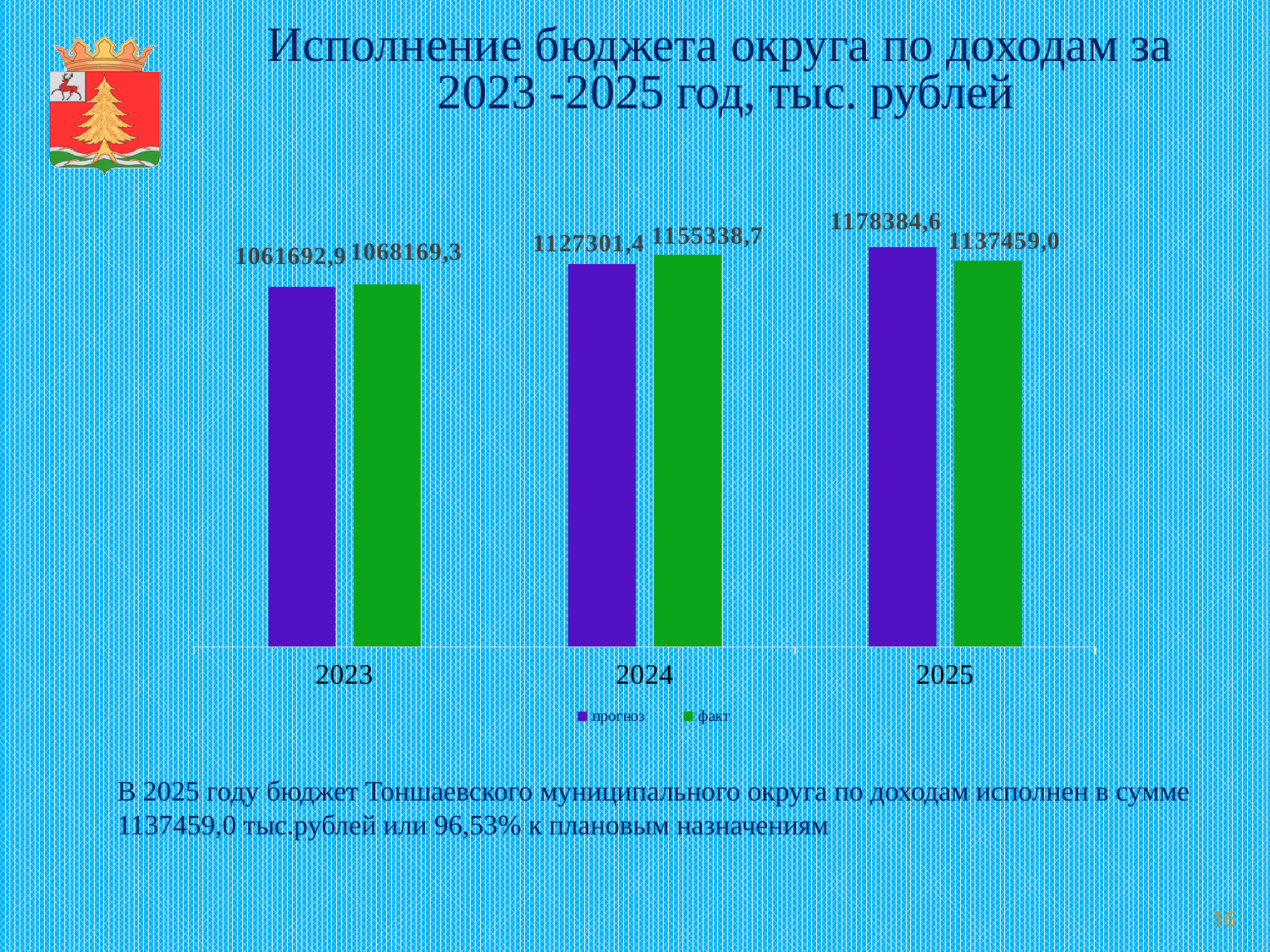
What is the difference between the прогноз and факт values for 2025? 40925,6 What is the факт value for 2023? 1068169,3 Do the прогноз values rise or fall from 2023 to 2025? rise How many series does the legend list? 2 How many years are shown on the x axis? 3 Which year has the highest прогноз value? 2025 Which year has the lowest факт value? 2023 For 2025, which is larger: прогноз or факт? прогноз What is the факт value for 2025? 1137459,0 What kind of chart is shown on the slide? bar chart What is the difference between the факт and прогноз values for 2024? 28037,3 What is the прогноз value for 2024? 1127301,4